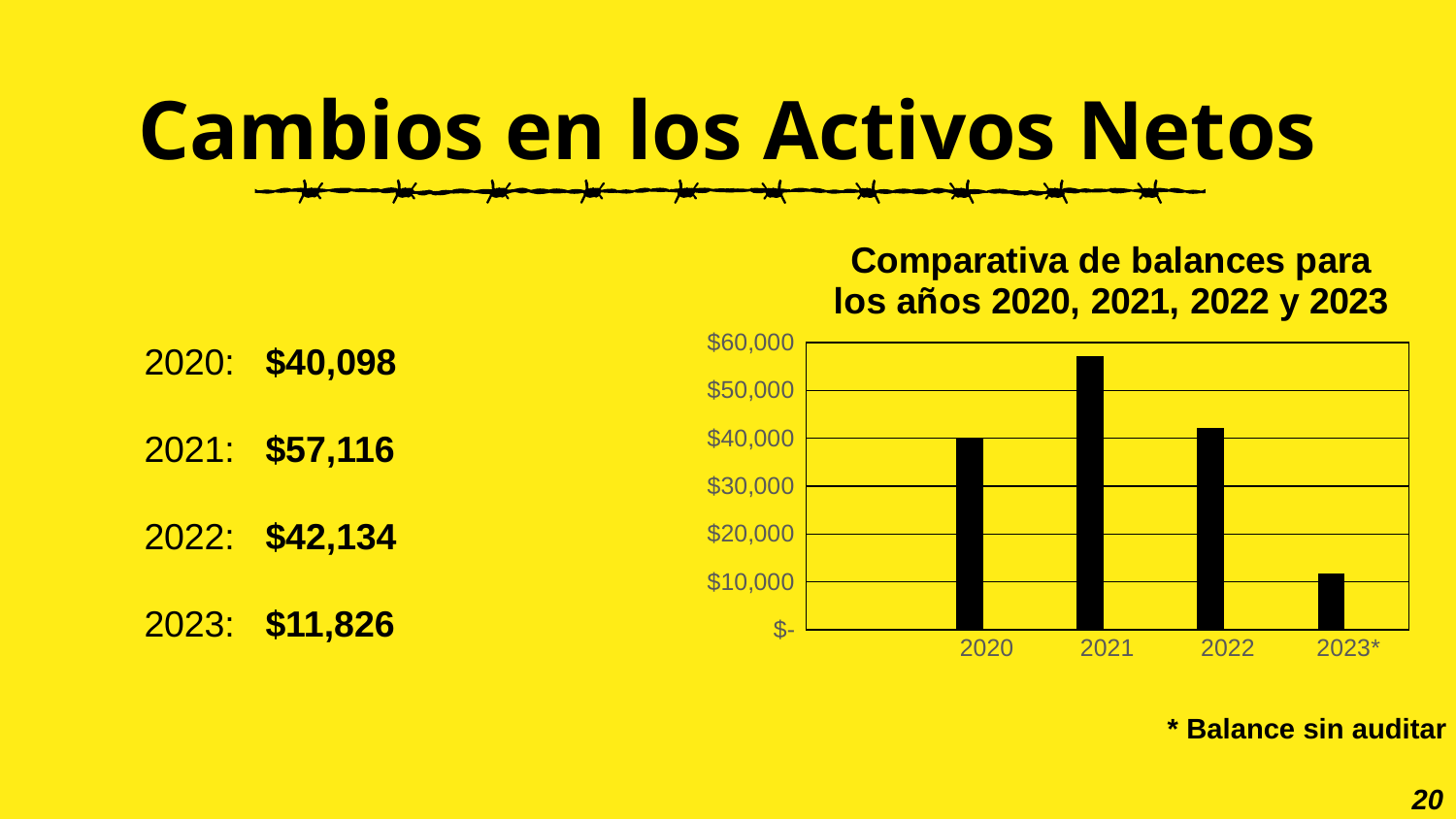
How many years are shown on the x axis of the chart? 4 What is the value for 2020 in the chart? $40,098 What is the difference between the values for 2021 and 2020? $17,018 Which year has the highest value in the chart? 2021 Which year has the lowest value in the chart? 2023 Is the value for 2023 greater or less than $20,000? less What is the value for 2023 in the chart? $11,826 Which is larger, the value for 2021 or the value for 2022? 2021 What kind of chart is shown on the slide? bar chart What is the difference between the values for 2022 and 2023? $30,308 What is the value for 2021 in the chart? $57,116 Do the values rise or fall from 2021 to 2023? fall